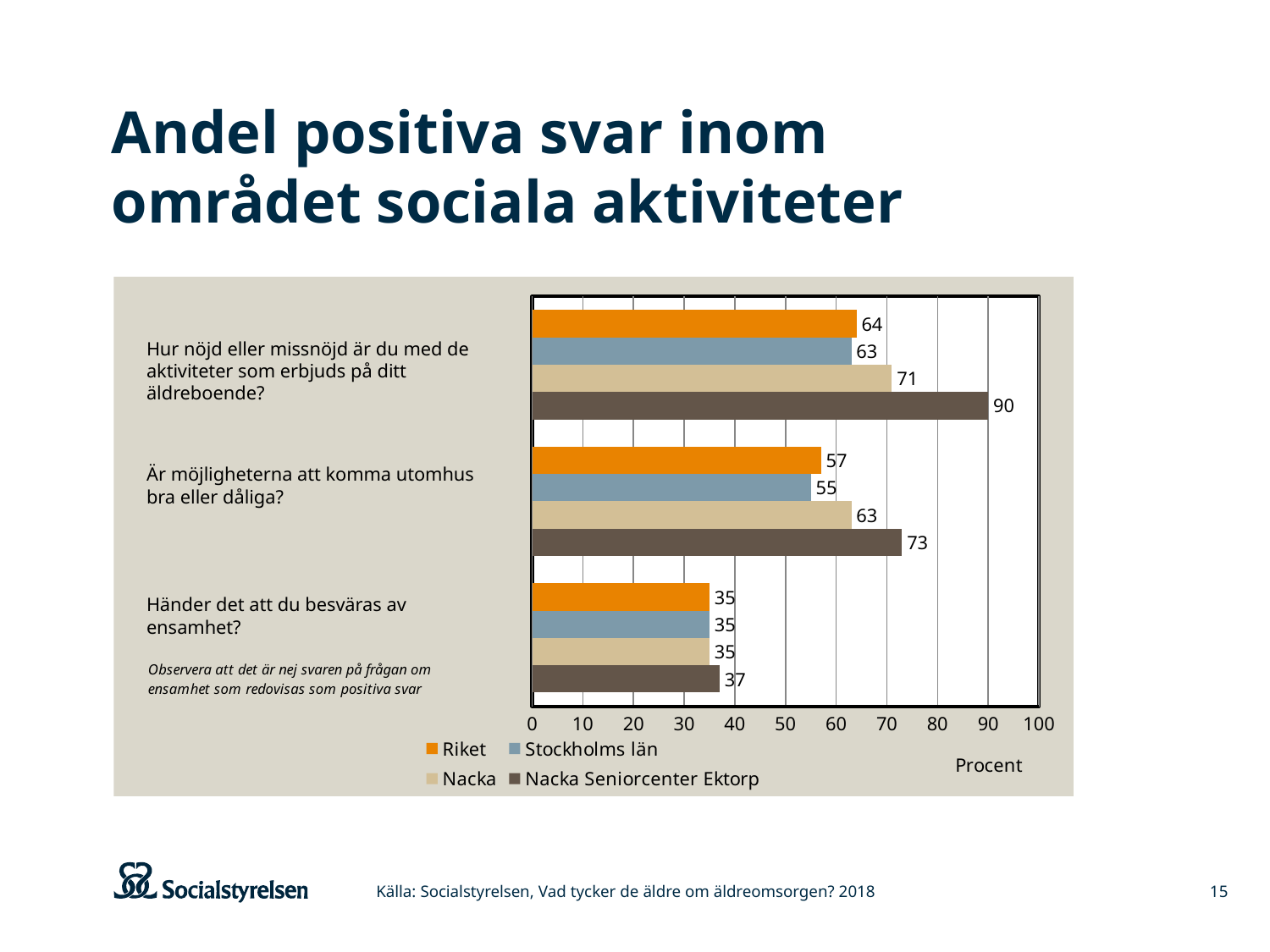
How many questions (categories) are shown in the chart? 3 What is the value for Riket on the question "Händer det att du besväras av ensamhet?"? 35 Which series has the highest value on the question "Är möjligheterna att komma utomhus bra eller dåliga?"? Nacka Seniorcenter Ektorp What kind of chart is shown on the slide? Bar chart How many series does the legend list? 4 Which is larger on the question "Är möjligheterna att komma utomhus bra eller dåliga?": Nacka or Riket? Nacka Which series has the lowest value on the question "Hur nöjd eller missnöjd är du med de aktiviteter som erbjuds på ditt äldreboende?"? Stockholms län What is the value for Nacka Seniorcenter Ektorp on the question "Hur nöjd eller missnöjd är du med de aktiviteter som erbjuds på ditt äldreboende?"? 90 What is the label of the x axis? Procent Is the value for Nacka Seniorcenter Ektorp on the question "Är möjligheterna att komma utomhus bra eller dåliga?" greater or less than 70? greater What is the difference between Nacka Seniorcenter Ektorp and Riket on the question "Hur nöjd eller missnöjd är du med de aktiviteter som erbjuds på ditt äldreboende?"? 26 What is the value for Stockholms län on the question "Är möjligheterna att komma utomhus bra eller dåliga?"? 55